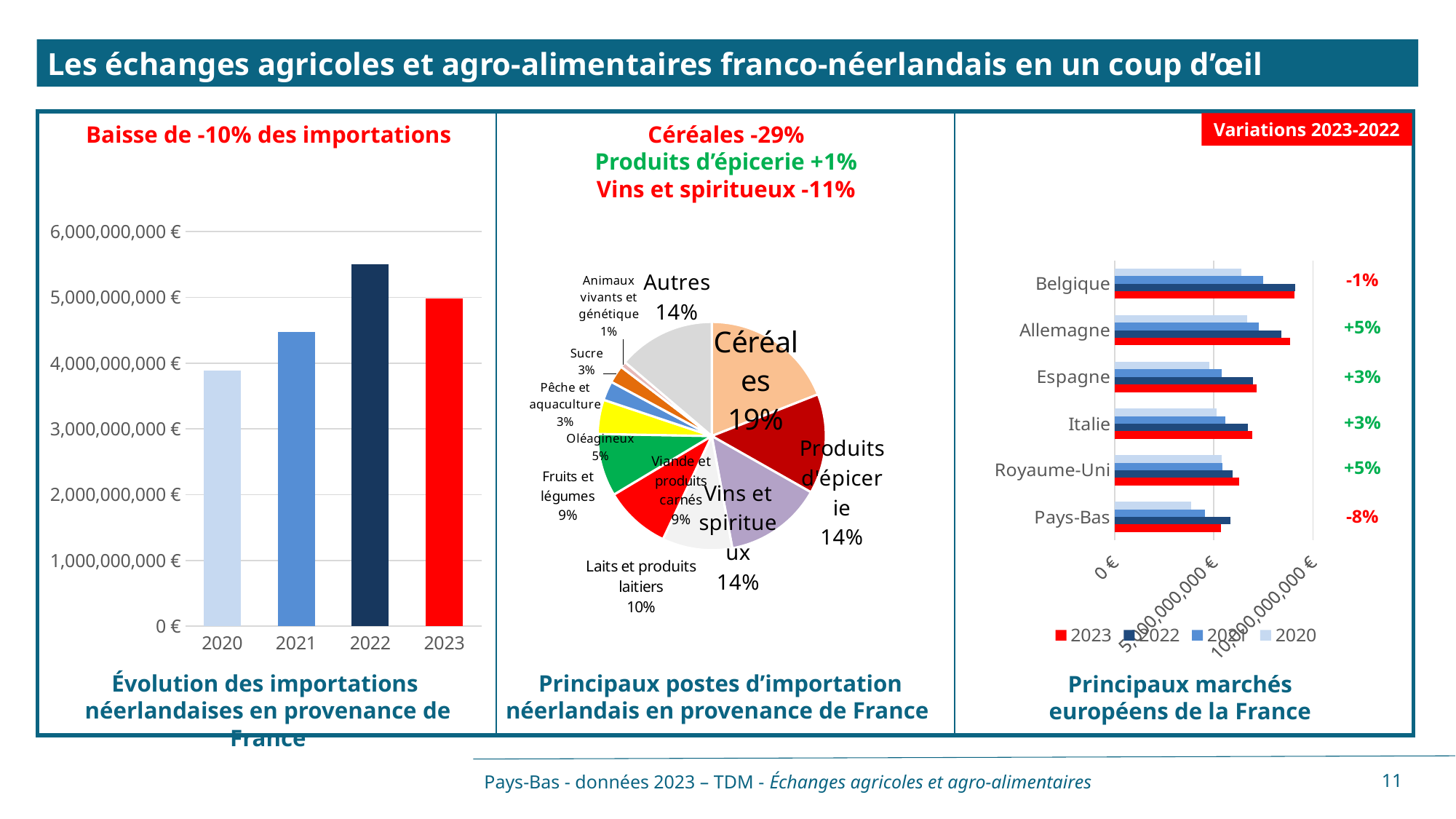
In the right chart 'Principaux marchés européens de la France', how many series does the legend list? 4 In the left chart 'Évolution des importations néerlandaises en provenance de France', which year has the lowest value? 2020 In the left chart 'Évolution des importations néerlandaises en provenance de France', is the value for 2022 greater or less than 5,000,000,000 €? greater In the left chart 'Évolution des importations néerlandaises en provenance de France', is the value for 2020 greater or less than 4,000,000,000 €? less In the left chart 'Évolution des importations néerlandaises en provenance de France', how many years are plotted? 4 In the middle pie chart 'Principaux postes d'importation néerlandais en provenance de France', which category has the smallest share? Animaux vivants et génétique In the middle pie chart 'Principaux postes d'importation néerlandais en provenance de France', what share do Céréales represent? 19% In the right chart 'Principaux marchés européens de la France', what is the 2023-2022 variation shown for Pays-Bas? -8% In the right chart 'Principaux marchés européens de la France', which country has the lowest 2023 value? Pays-Bas In the left chart 'Évolution des importations néerlandaises en provenance de France', which year has the highest value? 2022 In the middle pie chart 'Principaux postes d'importation néerlandais en provenance de France', what is the difference in percentage points between Céréales and Laits et produits laitiers? 9 What kind of chart is the left chart, 'Évolution des importations néerlandaises en provenance de France'? bar chart